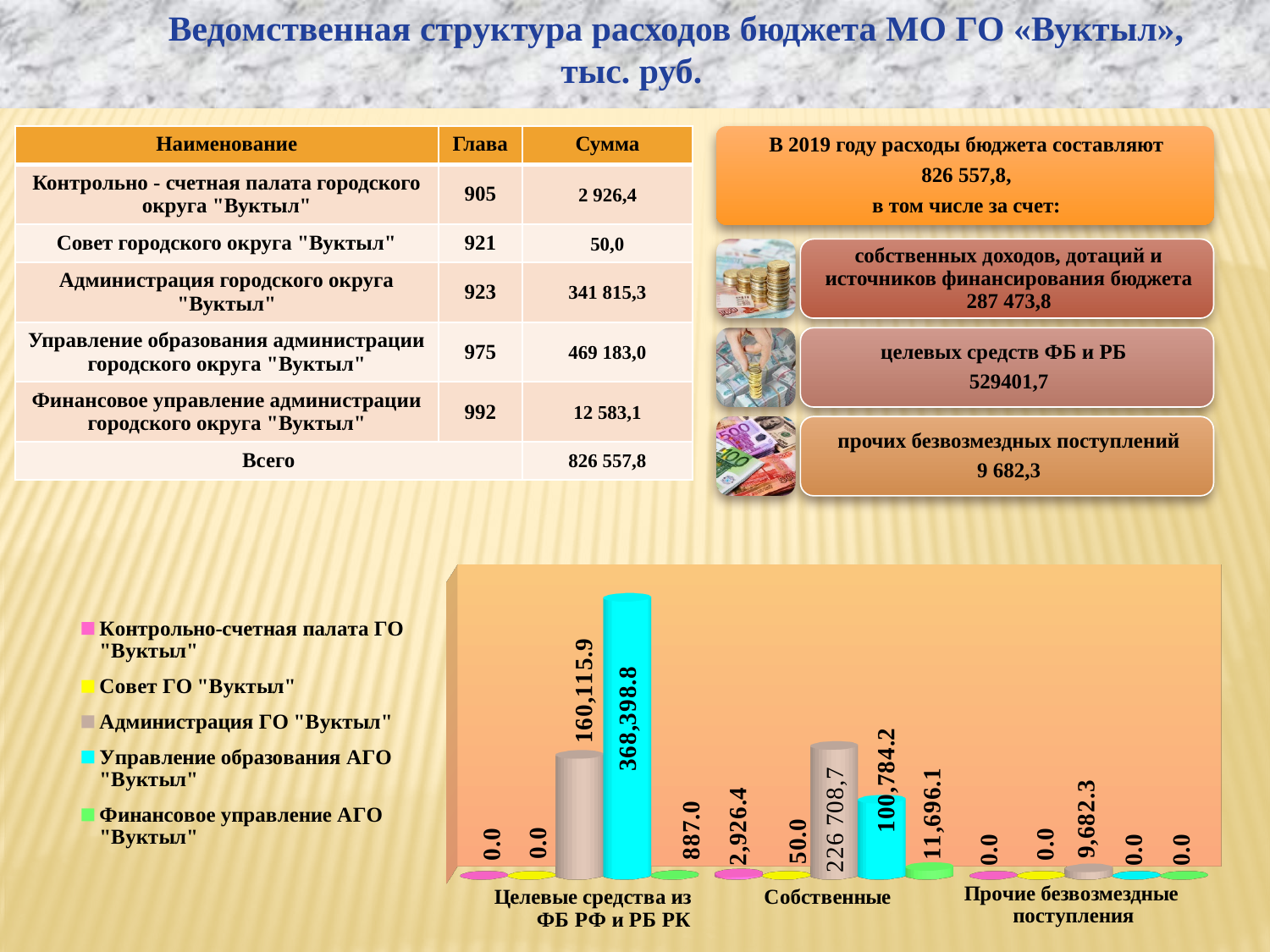
How many categories are shown on the x axis of the chart? 3 Which series has the highest value in the category Собственные? Администрация ГО "Вуктыл" What is the value for Управление образования АГО "Вуктыл" in the category Целевые средства из ФБ РФ и РБ РК? 368,398.8 In the category Собственные, which is larger: the value for Управление образования АГО "Вуктыл" or the value for Финансовое управление АГО "Вуктыл"? Управление образования АГО "Вуктыл" How many series does the chart legend list? 5 What kind of chart is shown at the bottom of the slide? bar chart What is the difference between the values for Управление образования АГО "Вуктыл" and Администрация ГО "Вуктыл" in the category Целевые средства из ФБ РФ и РБ РК? 208,282.9 What is the value for Администрация ГО "Вуктыл" in the category Прочие безвозмездные поступления? 9,682.3 What is the value for Финансовое управление АГО "Вуктыл" in the category Собственные? 11,696.1 Which series has the highest value in the category Целевые средства из ФБ РФ и РБ РК? Управление образования АГО "Вуктыл" What is the value for Контрольно-счетная палата ГО "Вуктыл" in the category Собственные? 2,926.4 What is the value for Администрация ГО "Вуктыл" in the category Целевые средства из ФБ РФ и РБ РК? 160,115.9